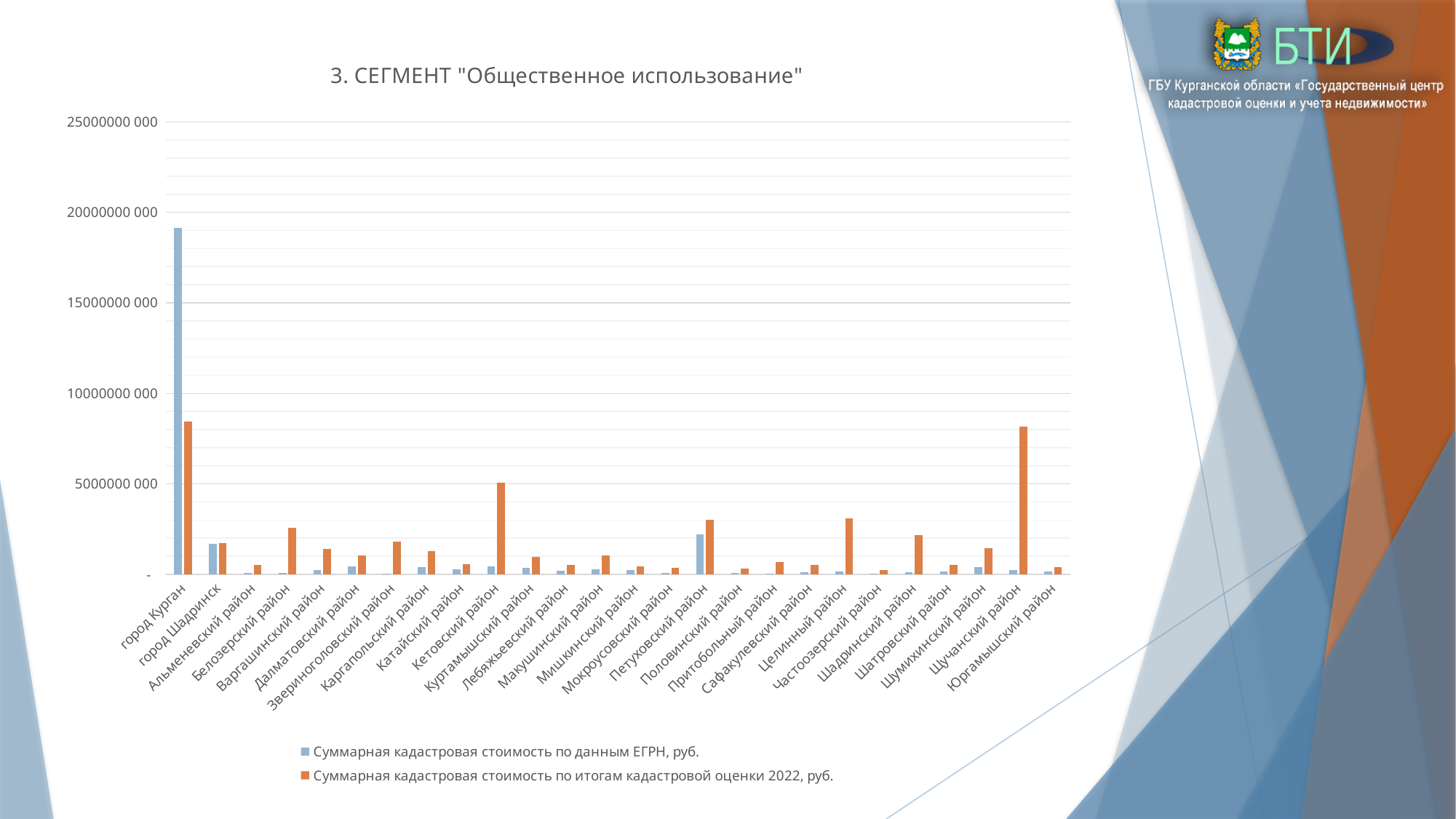
Is the value for Щучанский район in the series 'Суммарная кадастровая стоимость по итогам кадастровой оценки 2022, руб.' greater or less than 5000000 000? greater Which colour represents the series 'Суммарная кадастровая стоимость по итогам кадастровой оценки 2022, руб.'? orange Is the value for Петуховский район in the series 'Суммарная кадастровая стоимость по итогам кадастровой оценки 2022, руб.' greater or less than 5000000 000? less How many categories are shown along the x axis? 26 Is the value for город Курган in the series 'Суммарная кадастровая стоимость по данным ЕГРН, руб.' greater or less than 15000000 000? greater For Щучанский район, which series has the larger value: 'по данным ЕГРН' or 'по итогам кадастровой оценки 2022'? по итогам кадастровой оценки 2022 What type of chart is shown on the slide? bar chart Which category has the highest value for 'Суммарная кадастровая стоимость по данным ЕГРН, руб.'? город Курган What is the title of the chart? 3. СЕГМЕНТ "Общественное использование" For город Курган, which series has the larger value: 'по данным ЕГРН' or 'по итогам кадастровой оценки 2022'? по данным ЕГРН How many series does the legend list? 2